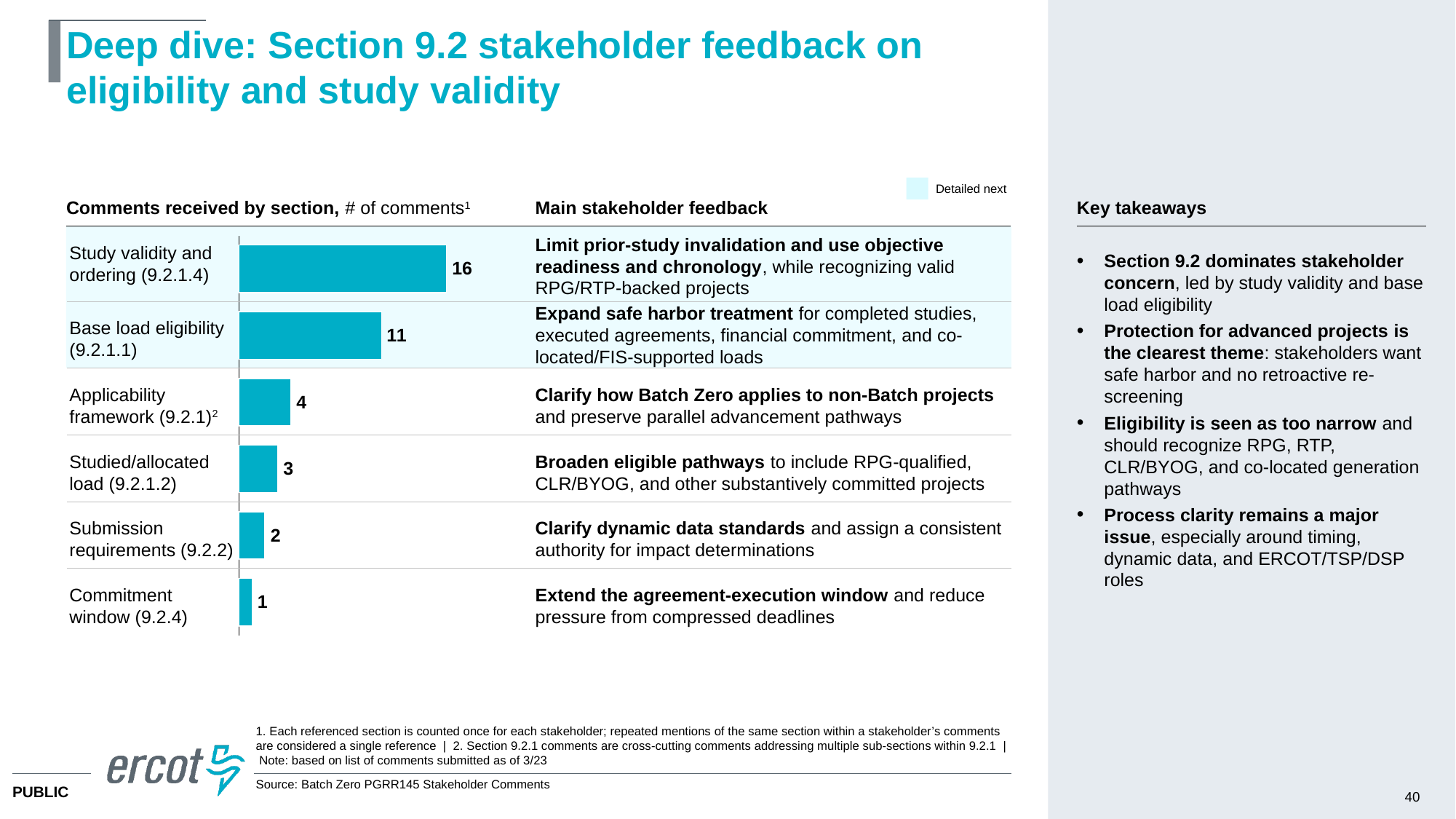
Which section received the most comments? Study validity and ordering (9.2.1.4) Which section received the fewest comments? Commitment window (9.2.4) What type of chart is used to show comments received by section? Bar chart How many comments were received for Base load eligibility (9.2.1.1)? 11 What is the total number of comments across all six sections shown in the chart? 37 What is the difference in number of comments between Study validity and ordering (9.2.1.4) and Base load eligibility (9.2.1.1)? 5 What is the title of the chart? Comments received by section, # of comments How many comments were received for Study validity and ordering (9.2.1.4)? 16 Which two sections are highlighted as 'Detailed next'? Study validity and ordering (9.2.1.4) and Base load eligibility (9.2.1.1) How many sections are shown in the chart? 6 Which received more comments: Applicability framework (9.2.1) or Studied/allocated load (9.2.1.2)? Applicability framework (9.2.1) How many comments were received for Submission requirements (9.2.2)? 2